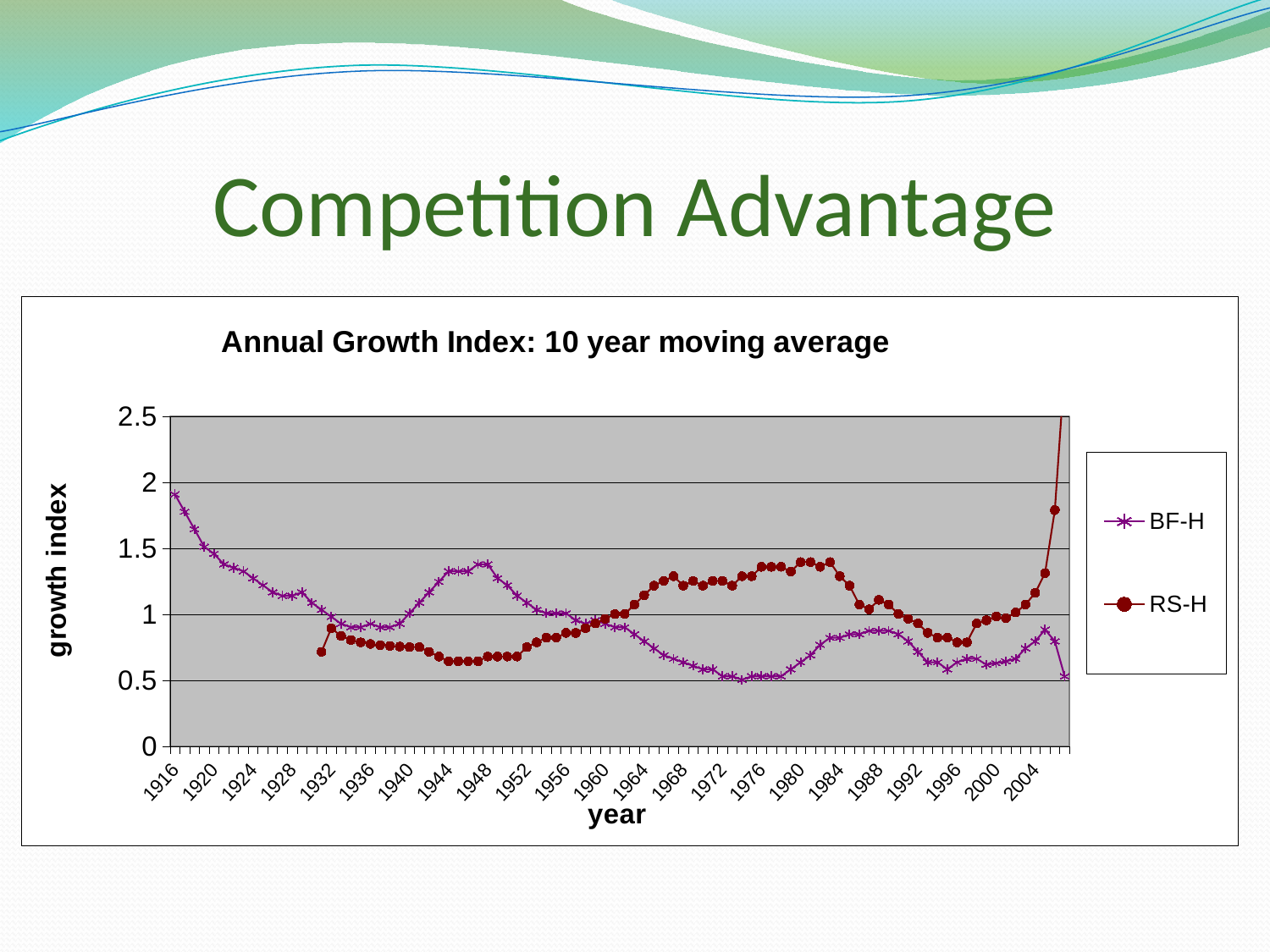
Which series has the larger value in 1980, BF-H or RS-H? RS-H Is the BF-H value for 1916 greater or less than 1.5? greater Is the RS-H value for 1932 greater or less than 1? less What kind of chart is shown on the slide? line chart What is the label of the vertical axis? growth index Does the RS-H series rise or fall from 1996 to the end of the chart? rise Which series has the larger value in 1944, BF-H or RS-H? BF-H Is the BF-H value for 1984 greater or less than 1? less What is the title of the chart? Annual Growth Index: 10 year moving average How many series does the legend list? 2 Does the BF-H series rise or fall from 1916 to 1932? fall